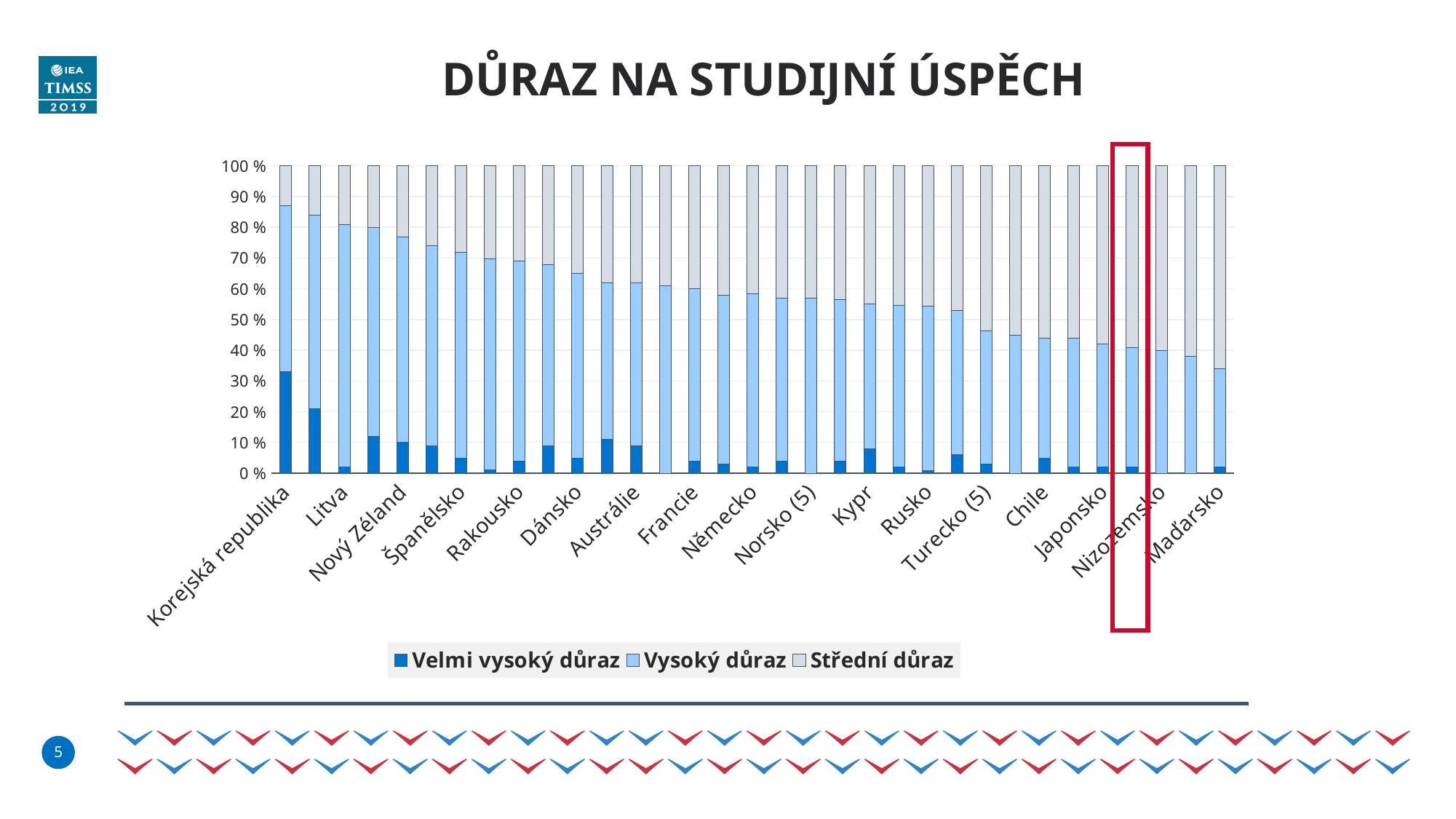
Is the Střední důraz value for Korejská republika greater or less than 20 %? less How many series does the legend list? 3 What are the three series named in the legend? Velmi vysoký důraz, Vysoký důraz, Střední důraz What kind of chart is shown on the slide? stacked bar chart Is the Střední důraz value for Maďarsko greater or less than 60 %? greater Which country has the highest value for Velmi vysoký důraz? Korejská republika Does the combined share of Velmi vysoký důraz and Vysoký důraz rise or fall from left to right across the chart? fall What is the title of the chart? DŮRAZ NA STUDIJNÍ ÚSPĚCH Which of the labelled countries has the largest Střední důraz share? Maďarsko Which has a larger Velmi vysoký důraz value, Nový Zéland or Litva? Nový Zéland Is the Velmi vysoký důraz value for Litva greater or less than 10 %? less